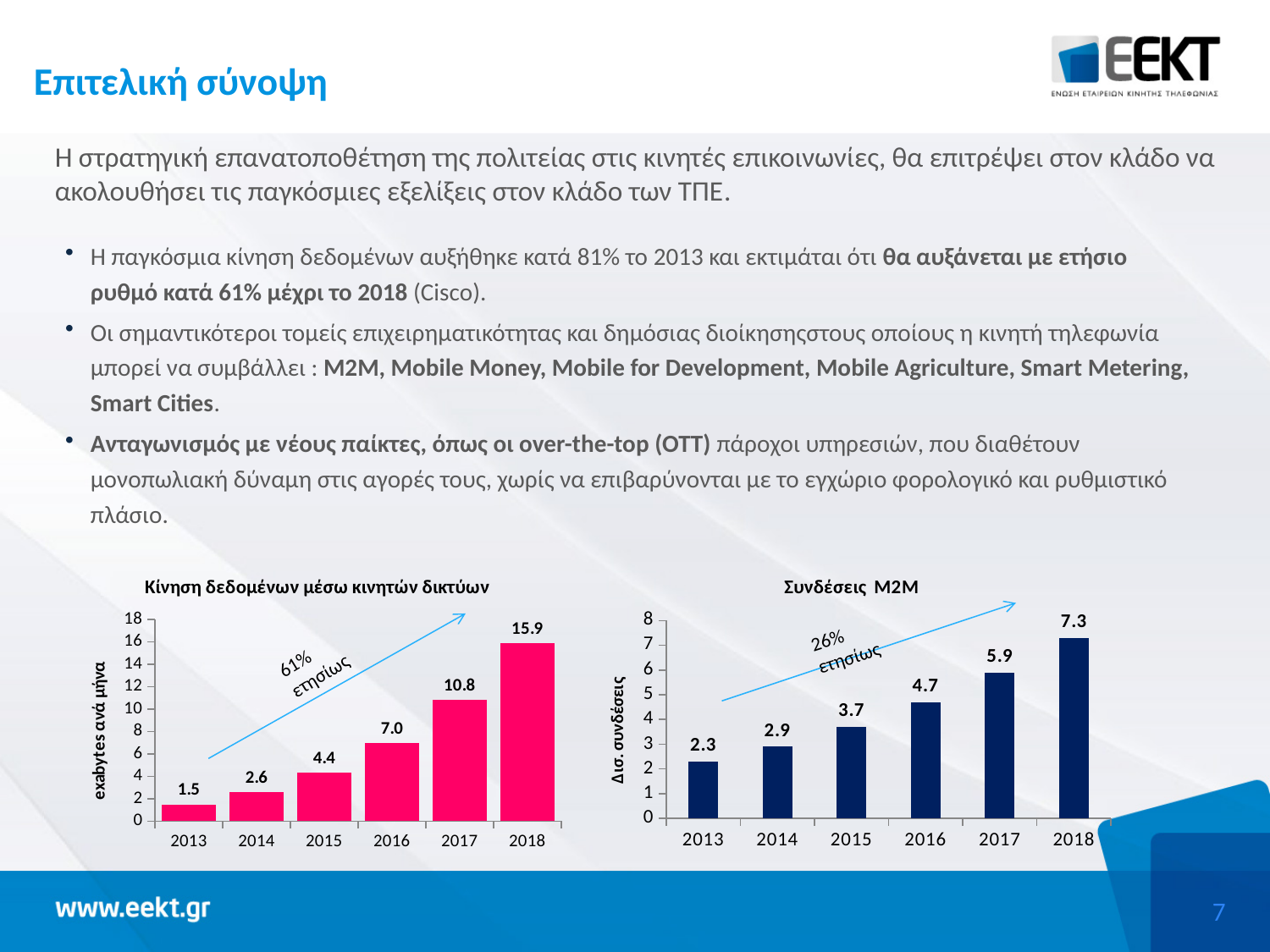
In the chart titled 'Κίνηση δεδομένων μέσω κινητών δικτύων', which is larger, the value for 2015 or the value for 2016? 2016 In the chart titled 'Κίνηση δεδομένων μέσω κινητών δικτύων', what is the value for 2016? 7.0 In the chart titled 'Συνδέσεις M2M', what is the value for 2015? 3.7 In the chart titled 'Κίνηση δεδομένων μέσω κινητών δικτύων', do the values rise or fall from 2013 to 2018? rise In the chart titled 'Κίνηση δεδομένων μέσω κινητών δικτύων', which year has the highest value? 2018 How many years are shown on the x axis of the chart titled 'Κίνηση δεδομένων μέσω κινητών δικτύων'? 6 In the chart titled 'Συνδέσεις M2M', which year has the lowest value? 2013 What kind of chart is the chart titled 'Συνδέσεις M2M'? bar chart In the chart titled 'Συνδέσεις M2M', what is the difference between the values for 2018 and 2013? 5.0 What is the y-axis label of the chart titled 'Συνδέσεις M2M'? Δισ. συνδέσεις In the chart titled 'Κίνηση δεδομένων μέσω κινητών δικτύων', what is the difference between the values for 2018 and 2017? 5.1 In the chart titled 'Συνδέσεις M2M', is the value for 2017 greater or less than 5? greater